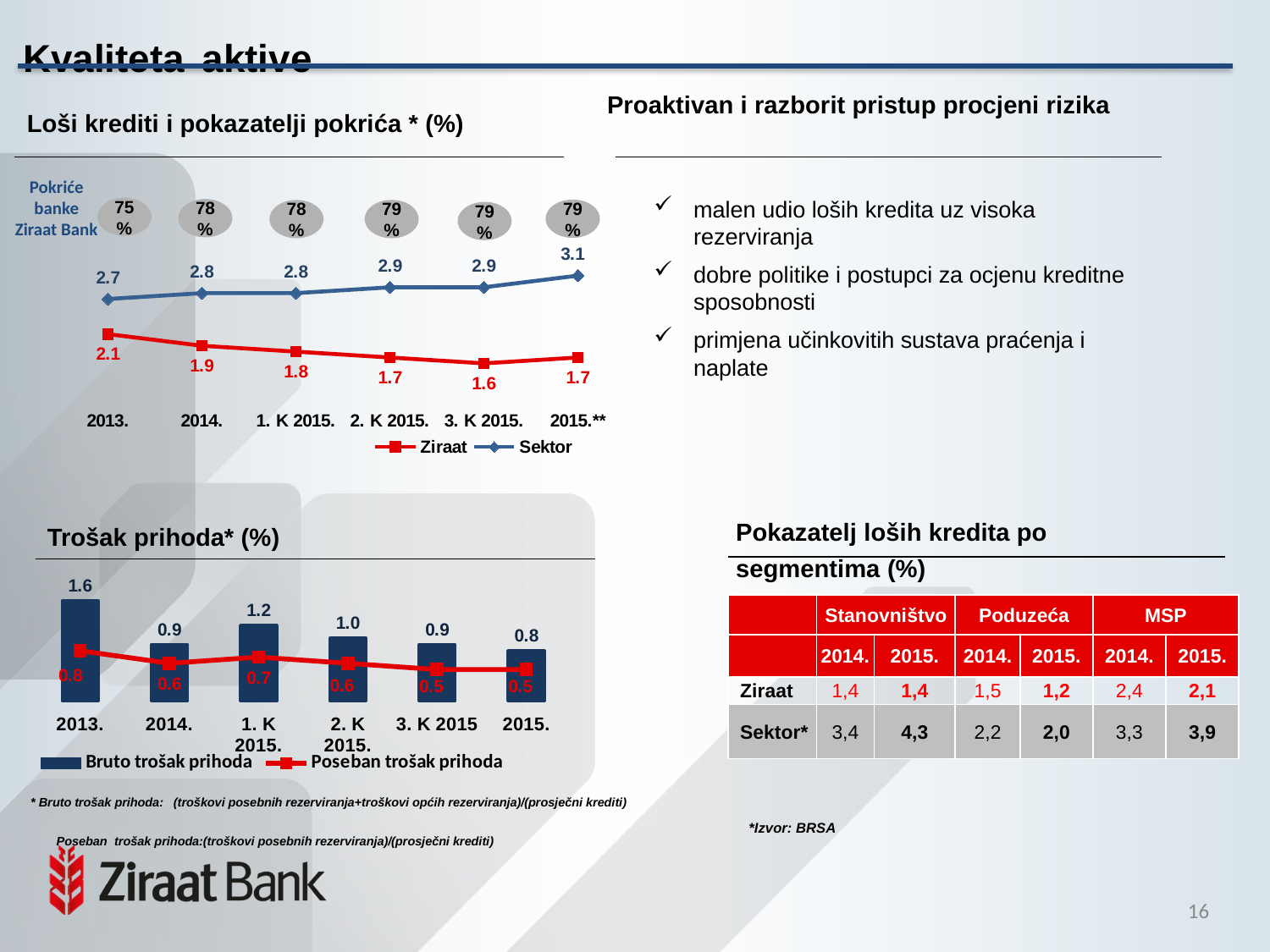
What kind of chart is 'Trošak prihoda* (%)'? combined bar and line chart In the 'Loši krediti i pokazatelji pokrića' chart, what is the Sektor value for 2015.**? 3.1 In the 'Loši krediti i pokazatelji pokrića' chart, how many series does the legend list? 2 In the 'Loši krediti i pokazatelji pokrića' chart, what is the Ziraat Bank coverage (Pokriće) shown for 2013.? 75% In the 'Loši krediti i pokazatelji pokrića' chart, what is the Ziraat value for 2013.? 2.1 In the 'Trošak prihoda* (%)' chart, what is the Poseban trošak prihoda value for 2015.? 0.5 In the 'Trošak prihoda* (%)' chart, how many periods are shown on the x axis? 6 In the 'Trošak prihoda* (%)' chart, which period has the highest Bruto trošak prihoda? 2013. In the 'Loši krediti i pokazatelji pokrića' chart, what is the difference between the Sektor and Ziraat values for 2014.? 0.9 In the 'Loši krediti i pokazatelji pokrića' chart, at which point is the Ziraat series lowest? 3. K 2015. In the 'Trošak prihoda* (%)' chart, what is the Bruto trošak prihoda value for 2013.? 1.6 In the 'Loši krediti i pokazatelji pokrića' chart, does the Sektor series rise or fall from 2013. to 2015.**? rise